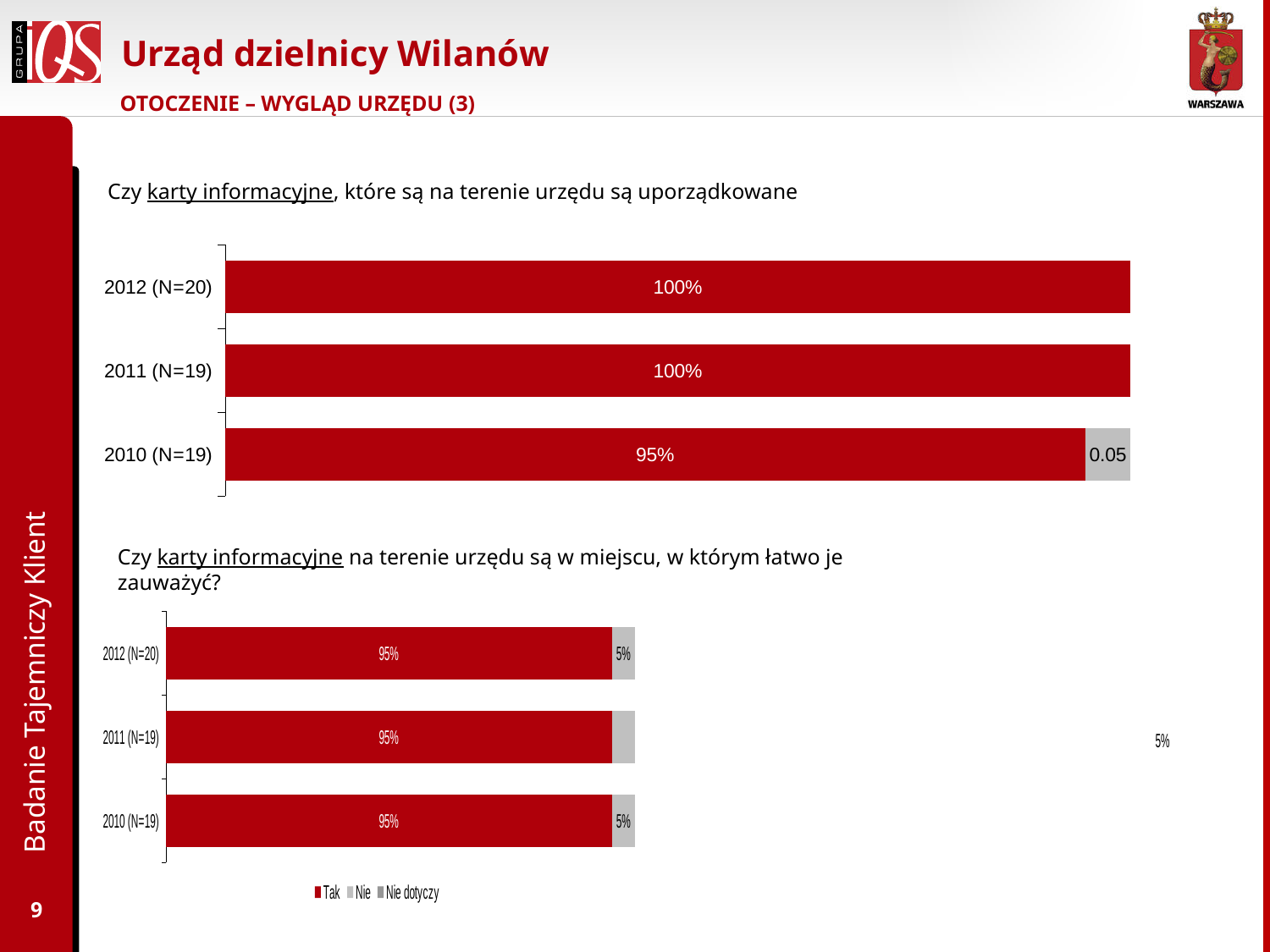
In the top chart, what is the difference between the 2011 (N=19) value and the red value for 2010 (N=19)? 5% How many series does the legend of the bottom chart list? 3 In the top chart, what is the value for 2012 (N=20)? 100% In the bottom chart, what is the total of the stacked bar for 2012 (N=20)? 100% In the top chart, what is the red 'Tak' value for 2010 (N=19)? 95% In the bottom chart, what is the red 'Tak' value for 2012 (N=20)? 95% What are the legend entries of the bottom chart? Tak, Nie, Nie dotyczy In the bottom chart, what is the grey value for 2010 (N=19)? 5% In the top chart, what label is shown on the grey segment for 2010 (N=19)? 0.05 What type of chart is the bottom chart? Bar chart How many categories (years) are shown in the top chart? 3 In the top chart, which year has the lowest red 'Tak' value? 2010 (N=19)